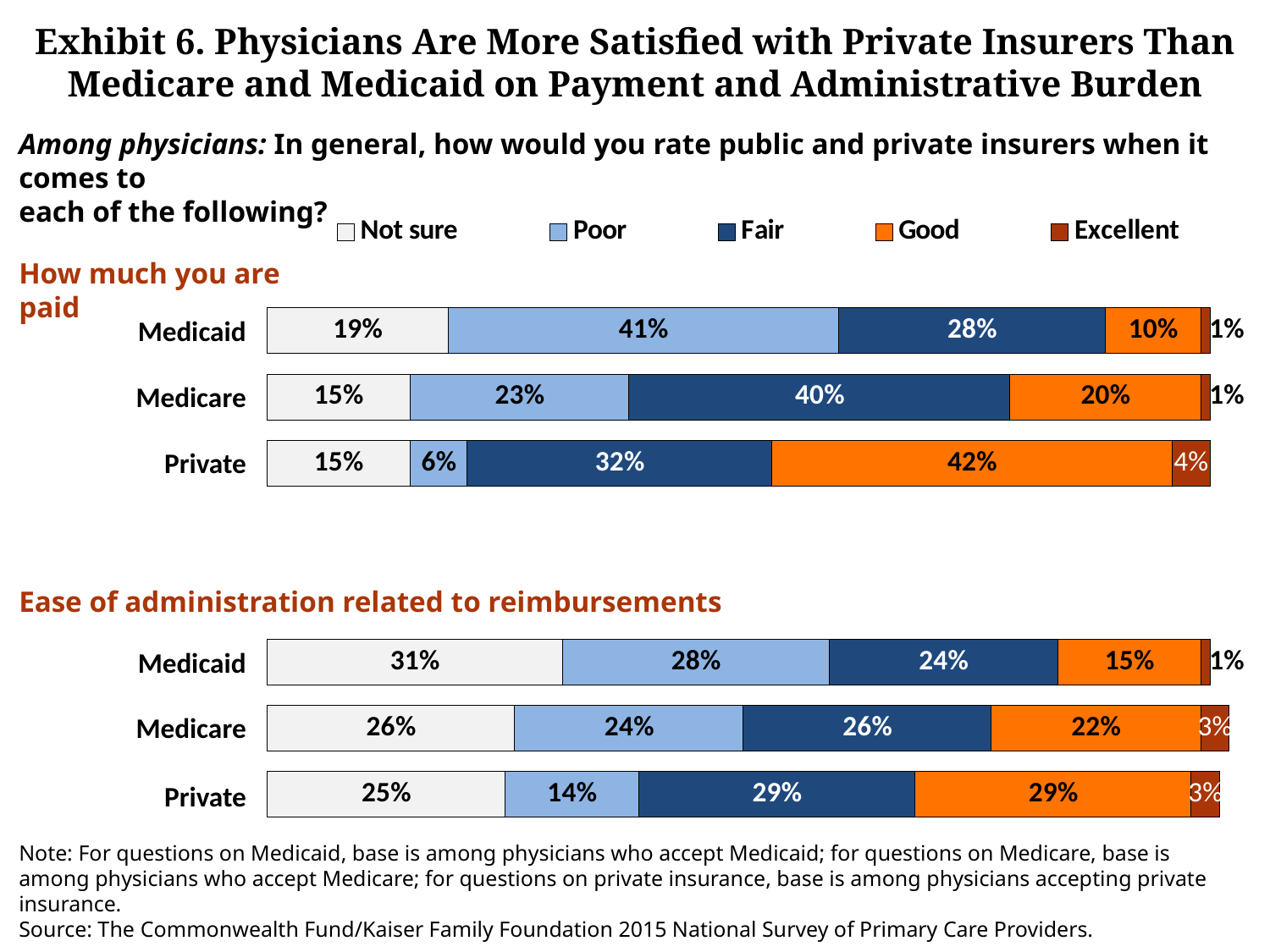
In the 'How much you are paid' chart, what percentage of physicians rated private insurers as Good? 42% In the 'Ease of administration related to reimbursements' chart, is the Poor rating higher for Medicaid or for Private? Medicaid How many insurer categories are shown in the 'Ease of administration related to reimbursements' chart? 3 In the 'Ease of administration related to reimbursements' chart, what percentage of physicians were Not sure about Medicaid? 31% What type of chart is used on this slide? Stacked bar chart How many series does the legend list? 5 In the 'How much you are paid' chart, which insurer has the lowest Poor rating? Private Which legend entry is shown in dark blue? Fair In the 'How much you are paid' chart, which insurer has the highest Good rating? Private In the 'How much you are paid' chart, what is the difference between the Fair rating for Medicare and the Fair rating for Medicaid? 12% In the 'How much you are paid' chart, what percentage of physicians rated Medicaid as Poor? 41% In the 'Ease of administration related to reimbursements' chart, what percentage of physicians rated Medicare as Excellent? 3%